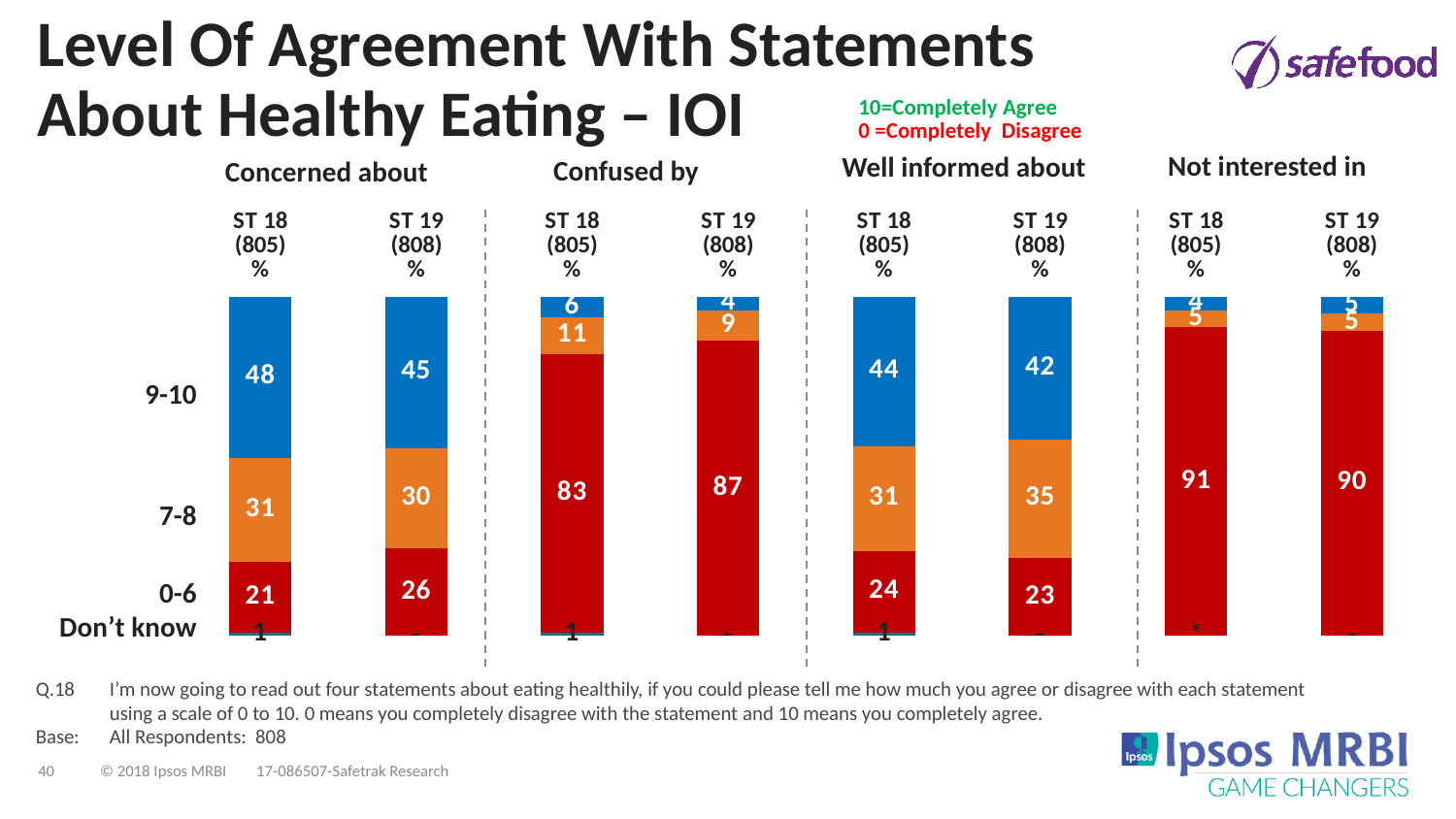
In the 'Concerned about' chart, what is the 9-10 value for ST 18? 48 What type of chart is used on this slide? Stacked bar chart In the 'Not interested in' chart, what is the 0-6 value for ST 18? 91 In the 'Confused by' chart, what is the 7-8 value for ST 18? 11 In the 'Confused by' chart, what is the 0-6 value for ST 19? 87 In the 'Confused by' chart, which bar has the larger 0-6 value, ST 18 or ST 19? ST 19 In the 'Concerned about' chart, what is the 0-6 value for ST 19? 26 How many statement charts are shown on the slide? 4 In the 'Concerned about' chart, which segment of the ST 19 bar is the largest? 9-10 In the 'Not interested in' chart, which segment of the ST 19 bar is the smallest? Don't know In the 'Well informed about' chart, what is the difference between the 9-10 values for ST 18 and ST 19? 2 In the 'Well informed about' chart, what is the 7-8 value for ST 19? 35